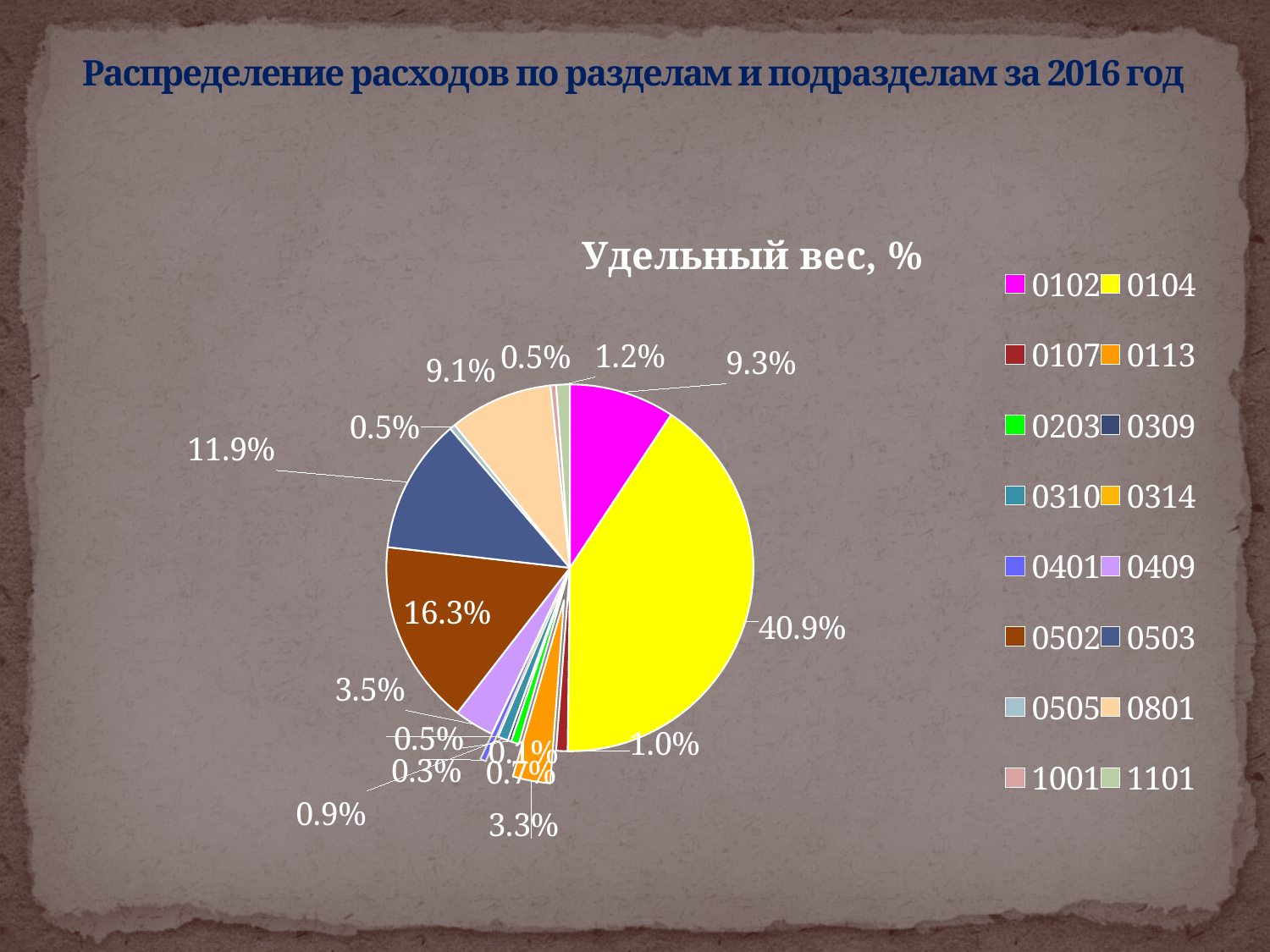
Which has the larger share, 0503 or 0801? 0503 What share of the pie does category 0801 have? 9.1% Which category has the largest share of the pie? 0104 What share of the pie does category 0502 have? 16.3% What kind of chart is shown on the slide? pie chart How many categories does the legend list? 16 What share of the pie does category 0102 have? 9.3% What is the title of the chart? Удельный вес, % What is the difference between the shares of 0104 and 0502? 24.6%